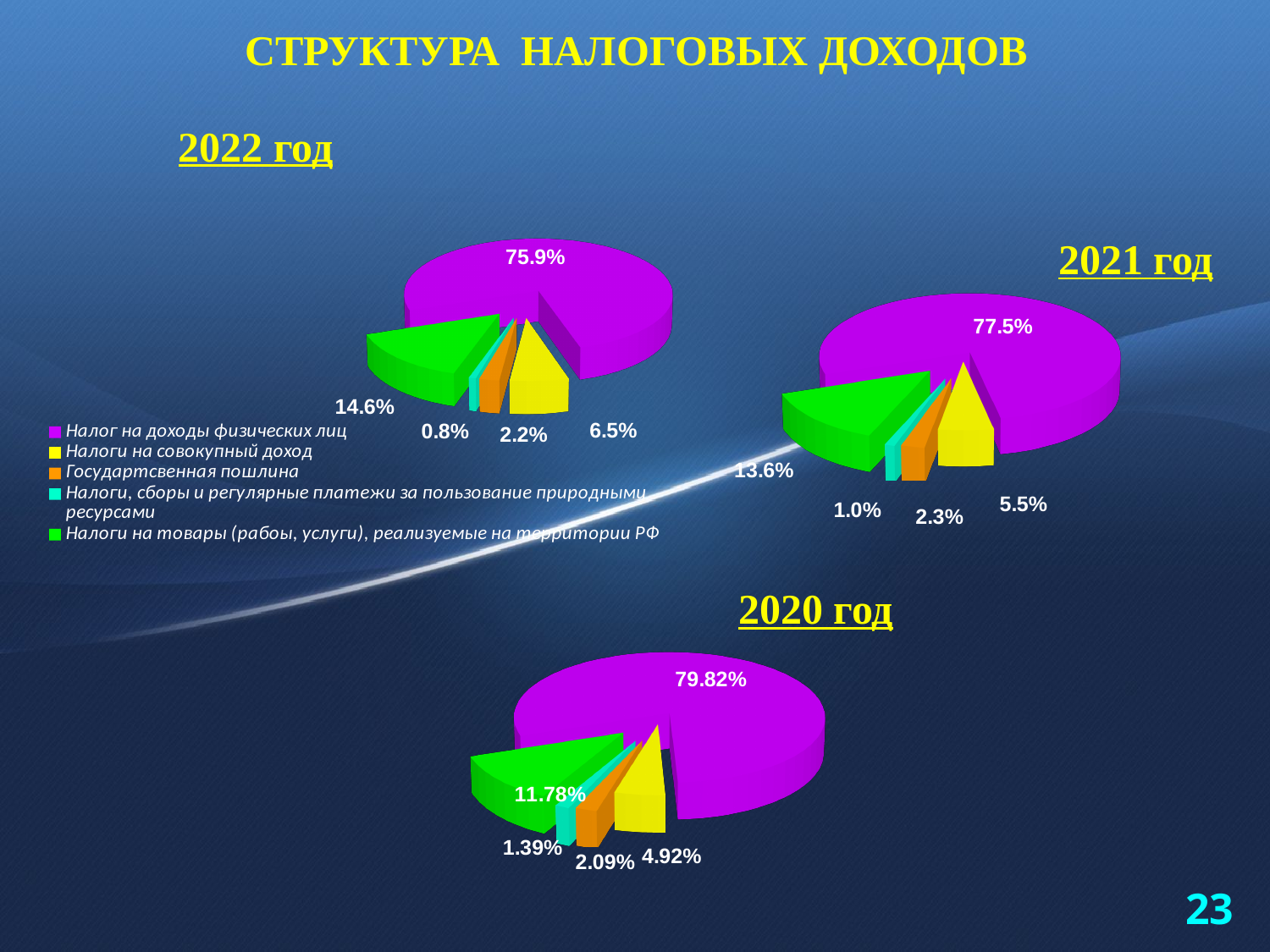
In the 2020 год pie chart, which category has the largest share? Налог на доходы физических лиц In the 2021 год pie chart, what share is shown for Налоги на товары (работы, услуги), реализуемые на территории РФ (green slice)? 13.6% How many categories does the legend list? 5 How many slices does the 2021 год pie chart have? 5 In the 2022 год pie chart, what share is shown for Налог на доходы физических лиц (purple slice)? 75.9% What type of chart is used to show the structure of tax revenues on this slide? Pie chart In the 2022 год pie chart, which category has the smallest share? Налоги, сборы и регулярные платежи за пользование природными ресурсами In the 2020 год pie chart, what share is shown for Налоги на совокупный доход (yellow slice)? 4.92% In the 2021 год pie chart, what share is shown for Государственная пошлина (orange slice)? 2.3% In the 2022 год pie chart, what is the difference between the share of Налог на доходы физических лиц and the share of Налоги на товары (работы, услуги), реализуемые на территории РФ? 61.3% Which colour represents Государственная пошлина in the legend? Orange Which is larger: the share of Налоги на совокупный доход in 2022 год or in 2021 год? 2022 год